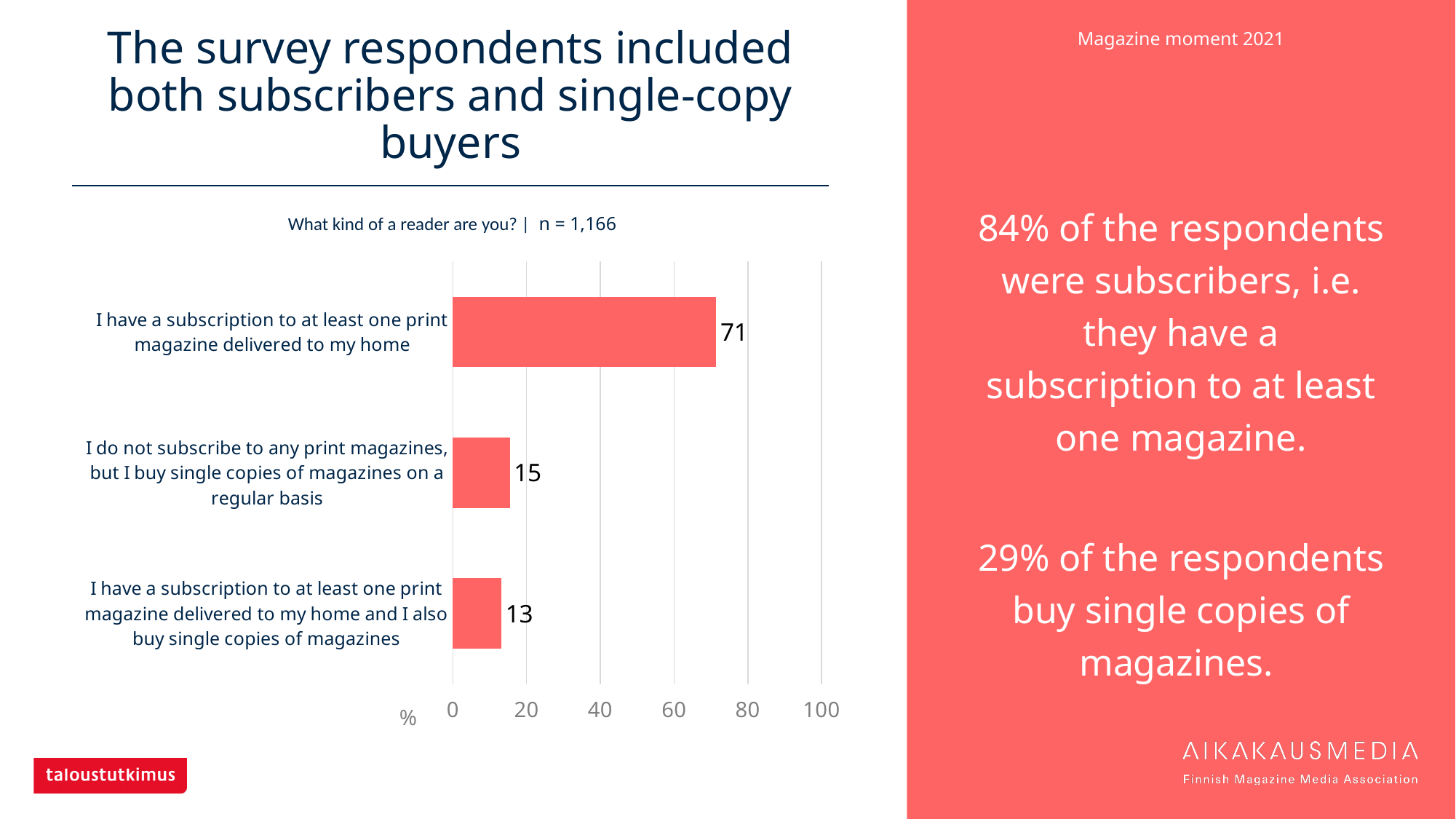
Which category has the highest value? I have a subscription to at least one print magazine delivered to my home What is the difference between the value for subscribers only (71) and the value for those who do not subscribe but buy single copies regularly (15)? 56 What is the value for "I have a subscription to at least one print magazine delivered to my home and I also buy single copies of magazines"? 13 What is the value for "I do not subscribe to any print magazines, but I buy single copies of magazines on a regular basis"? 15 What is the value for "I have a subscription to at least one print magazine delivered to my home"? 71 What is the sample size (n) shown above the chart? n = 1,166 What is the survey question shown above the chart? What kind of a reader are you? Which category has the lowest value? I have a subscription to at least one print magazine delivered to my home and I also buy single copies of magazines Which is larger: the value for "I do not subscribe to any print magazines, but I buy single copies of magazines on a regular basis" or the value for "I have a subscription to at least one print magazine delivered to my home and I also buy single copies of magazines"? I do not subscribe to any print magazines, but I buy single copies of magazines on a regular basis How many categories are shown in the chart? 3 Is the value for "I have a subscription to at least one print magazine delivered to my home" greater or less than 60? greater What kind of chart is shown on the slide? bar chart